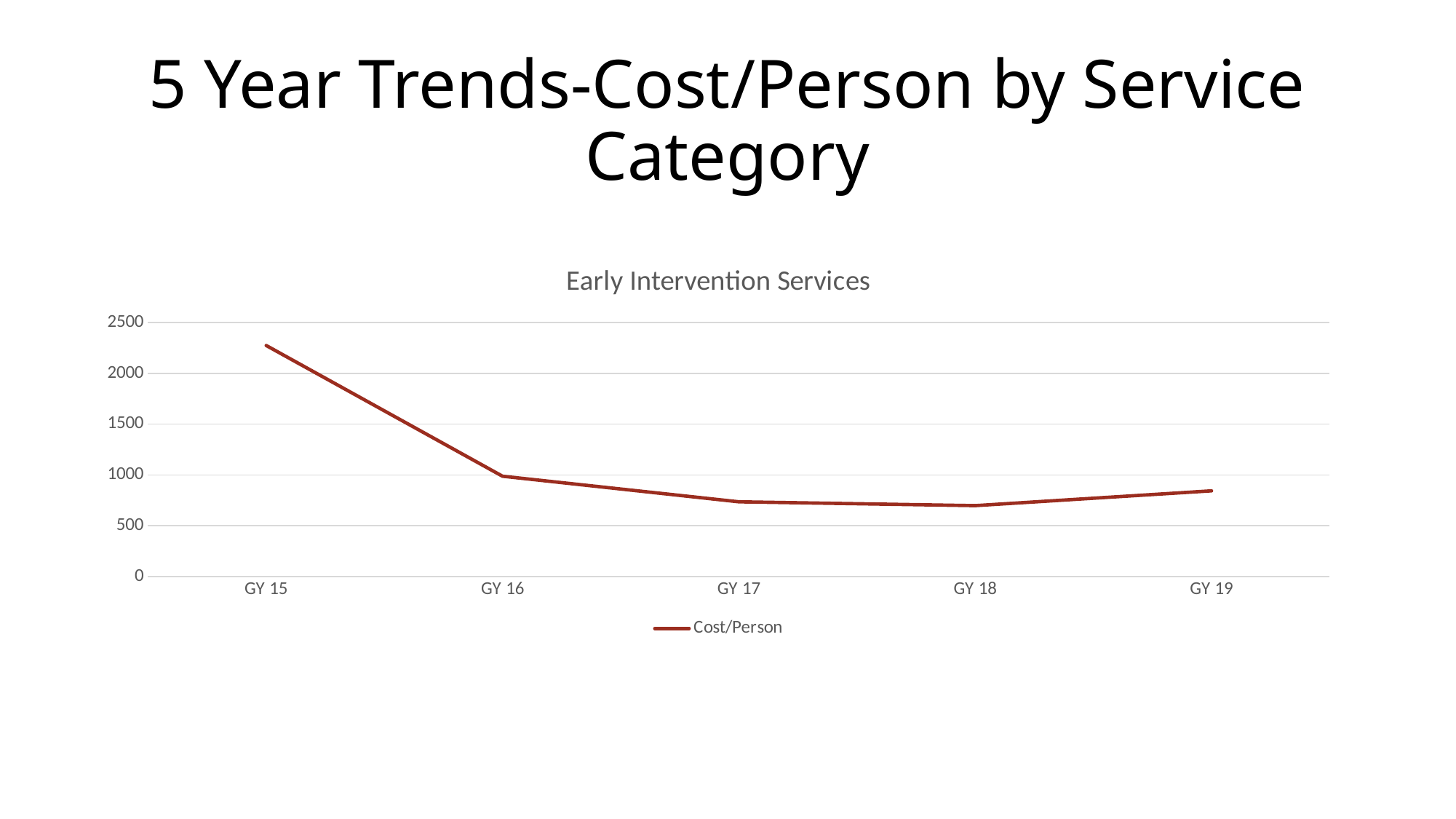
How many series does the legend list? 1 How many years are plotted on the x axis? 5 Does the Cost/Person rise or fall from GY 15 to GY 16? fall What is the name of the series shown in the legend? Cost/Person What kind of chart is shown on the slide? line chart Is the Cost/Person for GY 15 greater or less than 2000? greater Which year has the highest Cost/Person? GY 15 Which is larger, the Cost/Person for GY 15 or for GY 16? GY 15 Is the Cost/Person for GY 17 greater or less than 1000? less Is the Cost/Person for GY 18 greater or less than 500? greater What is the title of the chart? Early Intervention Services